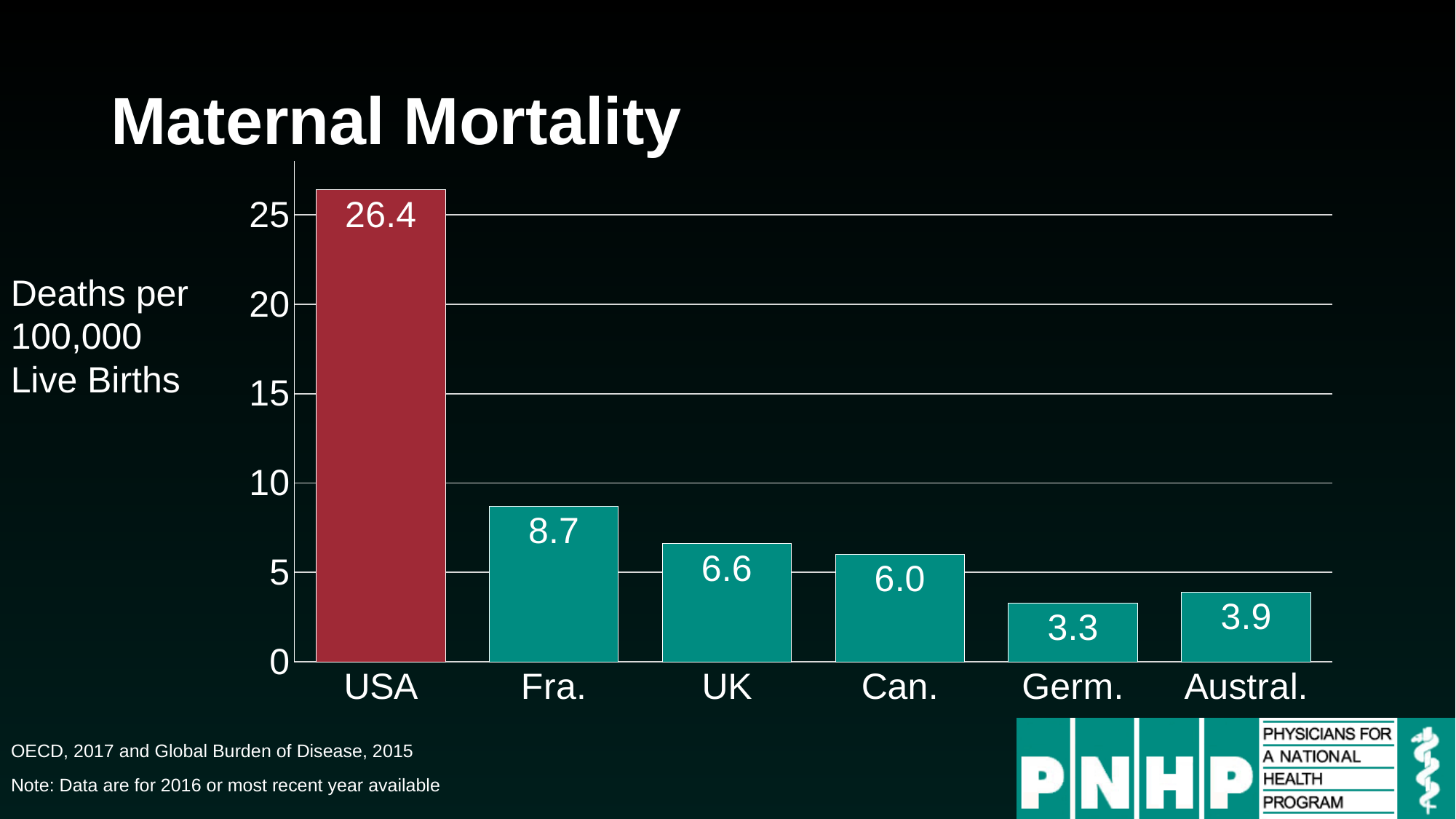
What is the maternal mortality value for Germ.? 3.3 Which country has the highest maternal mortality on the chart? USA Which country has the lowest maternal mortality on the chart? Germ. What is the maternal mortality value for the USA? 26.4 What kind of chart is shown on the slide? bar chart What is the maternal mortality value for Can.? 6.0 Which has a higher maternal mortality value, UK or Can.? UK What is the title of the chart? Maternal Mortality What is the difference between the Austral. value and the Germ. value? 0.6 Is the value for Fra. greater or less than 10? less What is the difference between the USA value and the Fra. value? 17.7 How many countries are shown on the chart? 6